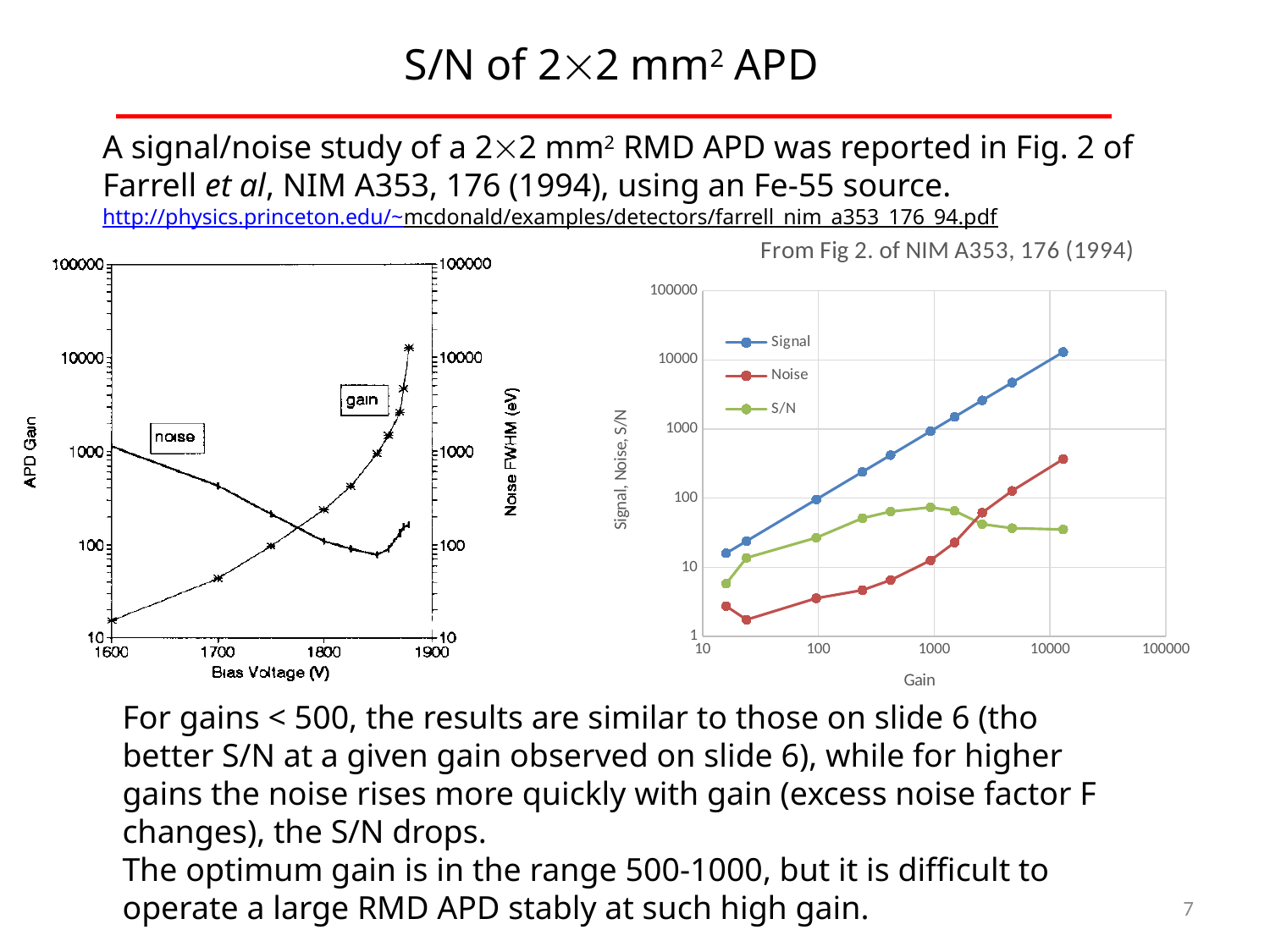
In the right-hand chart (From Fig 2. of NIM A353, 176 (1994)), is the Noise value at the highest gain plotted greater or less than 1000? less In the right-hand chart (From Fig 2. of NIM A353, 176 (1994)), does the Signal series rise or fall as Gain increases? Rise What kind of chart is the right-hand chart (From Fig 2. of NIM A353, 176 (1994))? Line chart In the left-hand chart (APD Gain vs Bias Voltage), does the gain curve rise or fall as bias voltage increases? Rise In the right-hand chart (From Fig 2. of NIM A353, 176 (1994)), what colour is the S/N series? Green In the right-hand chart (From Fig 2. of NIM A353, 176 (1994)), is the highest S/N value greater or less than 100? less In the left-hand chart (APD Gain vs Bias Voltage), is the APD gain at 1600 V greater or less than 100? less In the right-hand chart (From Fig 2. of NIM A353, 176 (1994)), how many series does the legend list? 3 In the right-hand chart (From Fig 2. of NIM A353, 176 (1994)), what is the label of the x axis? Gain In the left-hand chart (APD Gain vs Bias Voltage), what is the label of the x axis? Bias Voltage (V) In the right-hand chart (From Fig 2. of NIM A353, 176 (1994)), at a gain of about 1000, which is larger, Signal or Noise? Signal